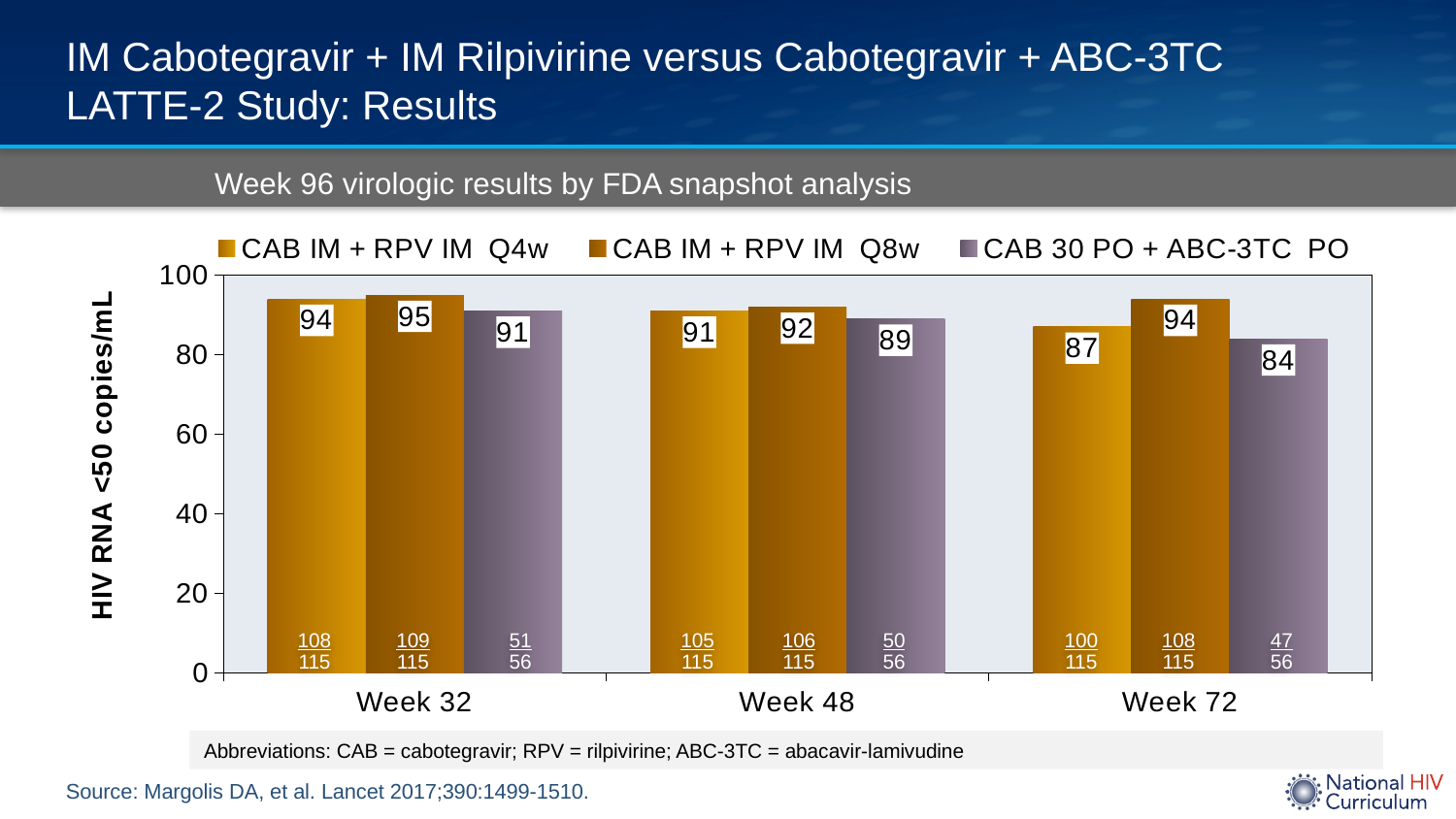
Do the values for CAB 30 PO + ABC-3TC PO rise or fall from Week 32 to Week 72? Fall How many time points (categories) are shown on the x axis? 3 Which series has the highest value at Week 72? CAB IM + RPV IM Q8w What is the difference between CAB IM + RPV IM Q8w and CAB 30 PO + ABC-3TC PO at Week 72? 10 What is the value for CAB 30 PO + ABC-3TC PO at Week 72? 84 Which series has the lowest value at Week 48? CAB 30 PO + ABC-3TC PO How many series does the legend list? 3 What is the value for CAB IM + RPV IM Q4w at Week 32? 94 Which is larger at Week 32: CAB IM + RPV IM Q4w or CAB 30 PO + ABC-3TC PO? CAB IM + RPV IM Q4w What kind of chart is shown on the slide? Bar chart What is the y-axis label of the chart? HIV RNA <50 copies/mL What is the value for CAB IM + RPV IM Q8w at Week 48? 92